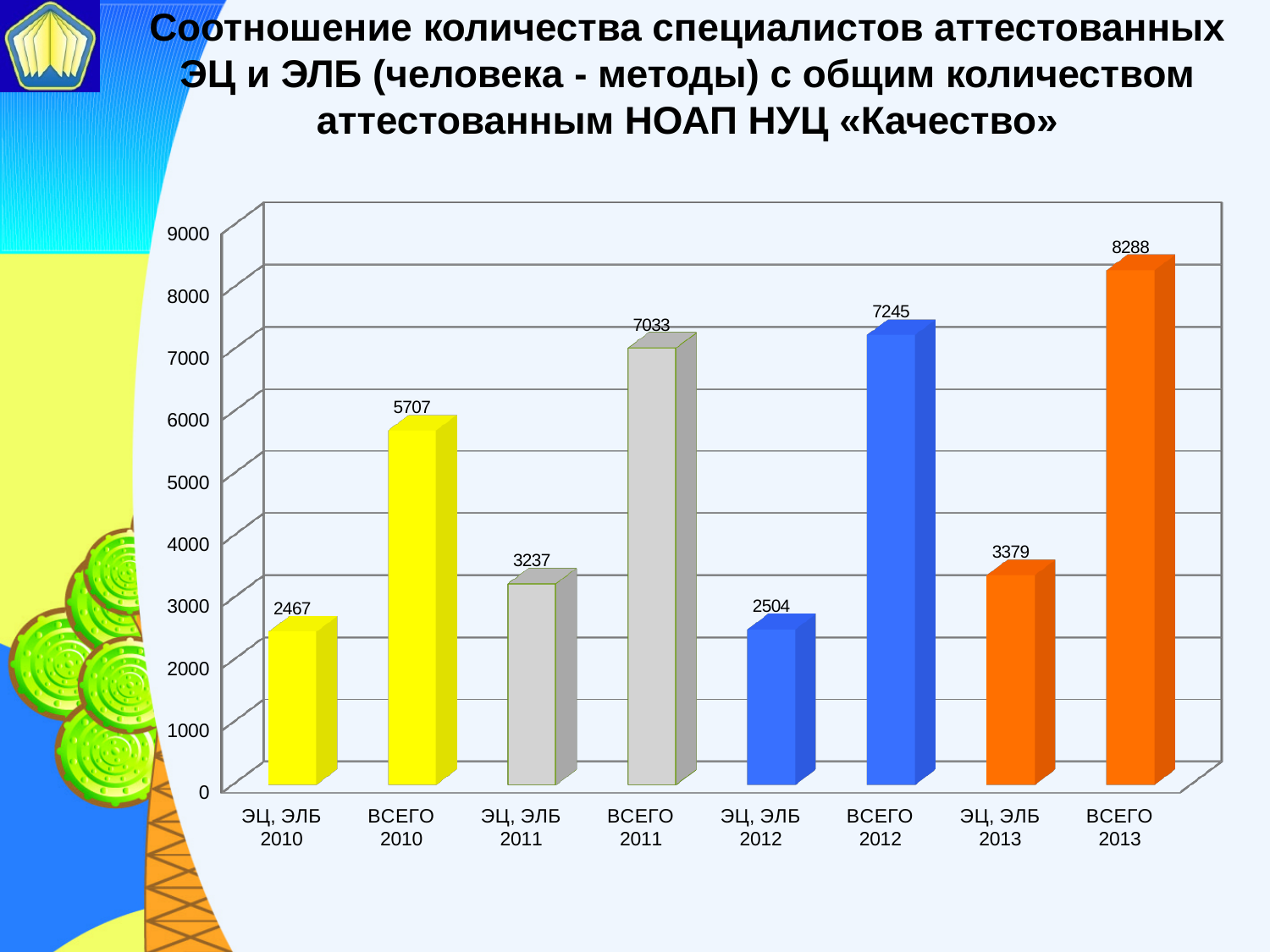
Which category has the highest value? ВСЕГО 2013 How many bars are shown in the chart? 8 What kind of chart is shown on the slide? bar chart What is the difference between ВСЕГО 2012 and ВСЕГО 2011? 212 What is the difference between ВСЕГО 2013 and ЭЦ, ЭЛБ 2013? 4909 Which category has the lowest value? ЭЦ, ЭЛБ 2010 What is the value for ВСЕГО 2011? 7033 What is the value for ЭЦ, ЭЛБ 2010? 2467 What is the value for ЭЦ, ЭЛБ 2013? 3379 Is the value for ВСЕГО 2010 greater or less than 6000? less Do the ВСЕГО values rise or fall from 2010 to 2013? rise Which is larger, ЭЦ, ЭЛБ 2011 or ЭЦ, ЭЛБ 2012? ЭЦ, ЭЛБ 2011